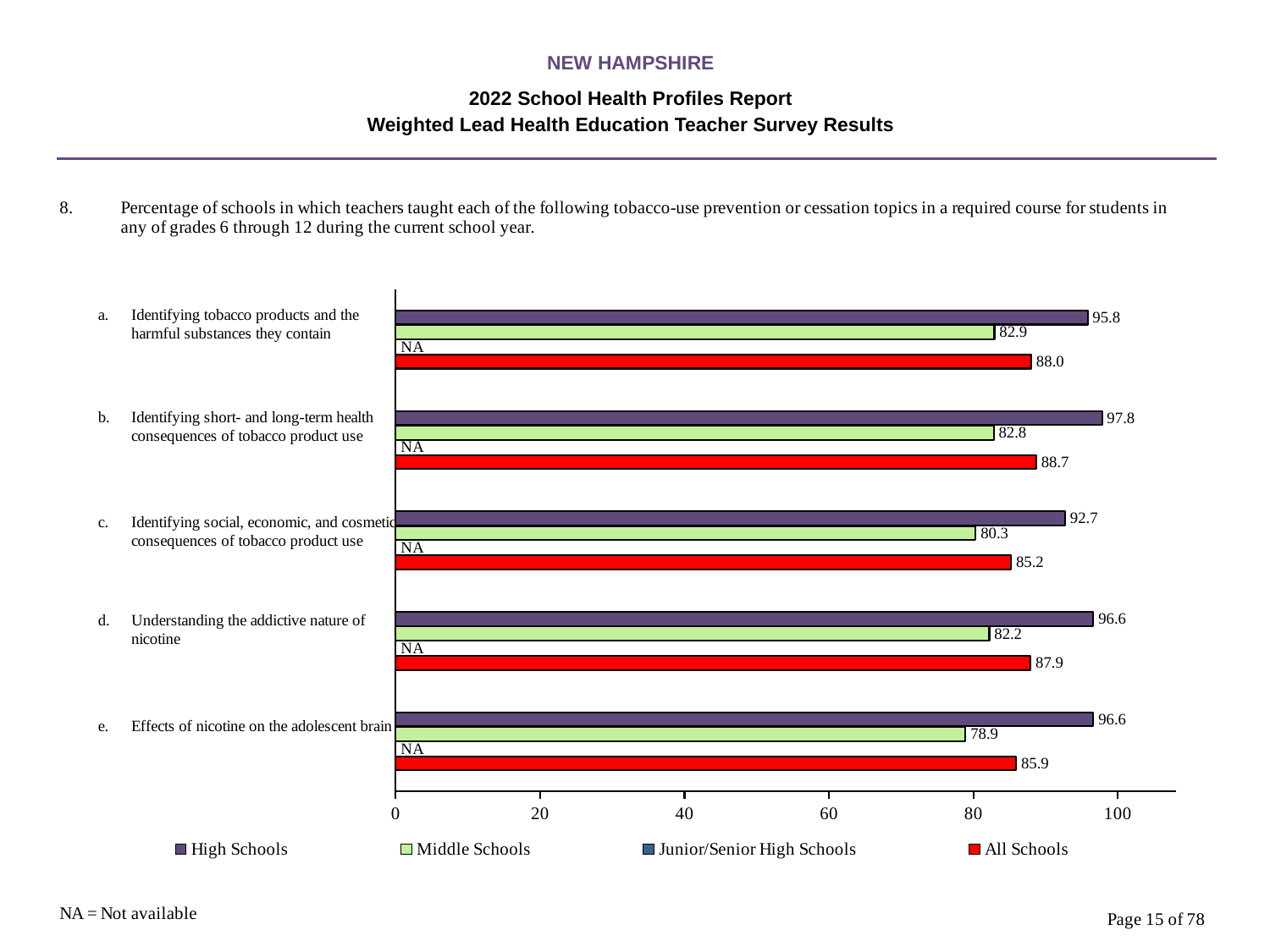
What is the Middle Schools value for 'Effects of nicotine on the adolescent brain'? 78.9 What colour are the All Schools bars? Red What is the High Schools value for 'Identifying short- and long-term health consequences of tobacco product use'? 97.8 What value is shown for Junior/Senior High Schools for 'Understanding the addictive nature of nicotine'? NA How many topics (categories) are plotted on the chart? 5 How many series does the legend list? 4 What is the All Schools value for 'Identifying social, economic, and cosmetic consequences of tobacco product use'? 85.2 What is the difference between the High Schools and Middle Schools values for 'Identifying tobacco products and the harmful substances they contain'? 12.9 Which topic has the lowest Middle Schools value? Effects of nicotine on the adolescent brain Which topic has the highest High Schools value? Identifying short- and long-term health consequences of tobacco product use What kind of chart is shown on the slide? Bar chart Which is larger: the All Schools value for 'Understanding the addictive nature of nicotine' or the All Schools value for 'Effects of nicotine on the adolescent brain'? Understanding the addictive nature of nicotine